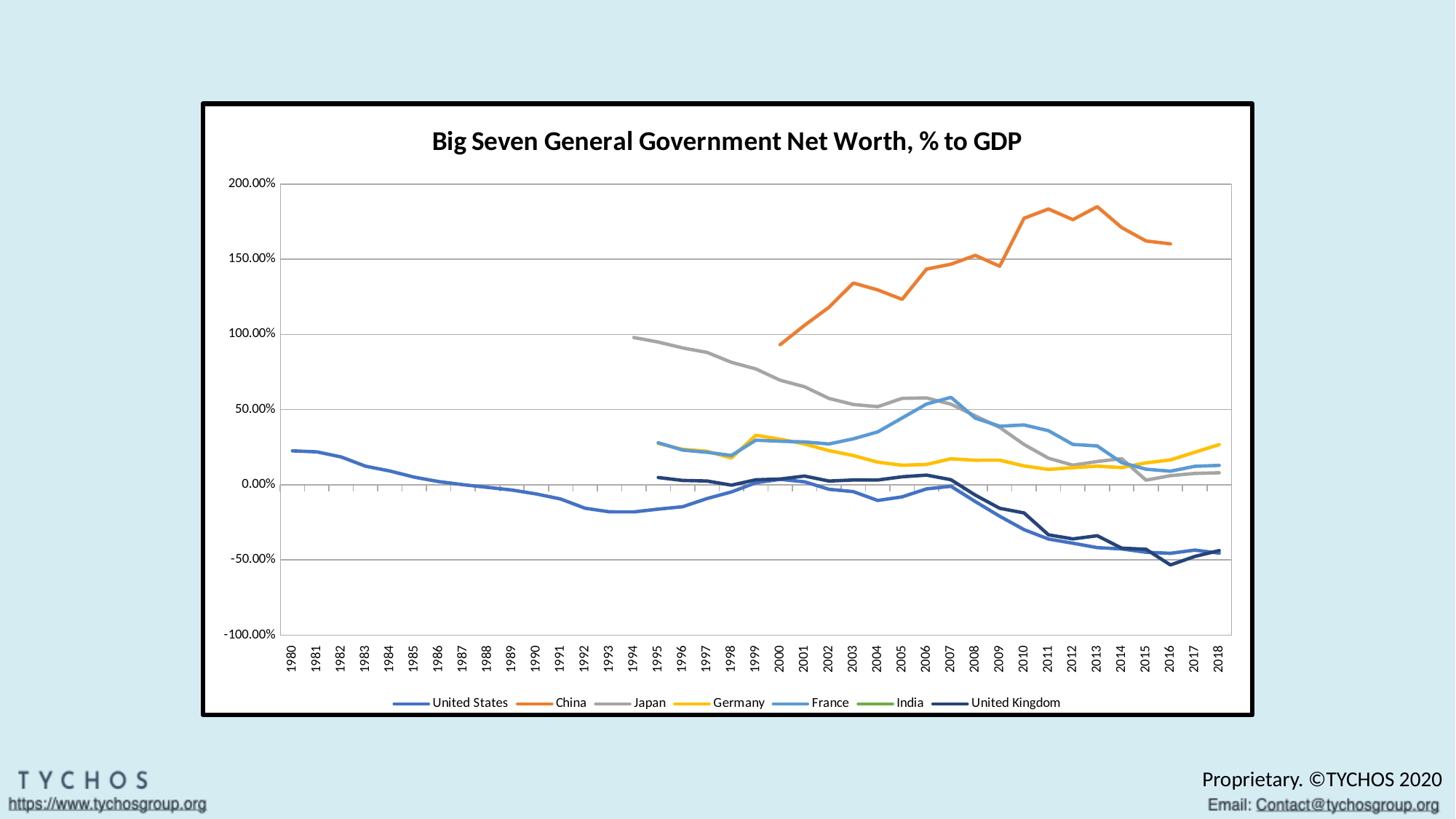
Which series has the highest value in 2018? Germany In 2018, which is larger: the value for Germany or the value for United Kingdom? Germany What is the title of the chart? Big Seven General Government Net Worth, % to GDP What kind of chart is shown on the slide? line chart Which series has the lowest value in 2016? United Kingdom Does the China line rise or fall from 2000 to 2013? rise Is the value for United States in 2016 greater or less than 0.00%? less Is the value for Japan in 1994 greater or less than 50.00%? greater Is the value for China in 2013 greater or less than 150.00%? greater Does the Japan line rise or fall from 1994 to 2015? fall How many series does the legend list? 7